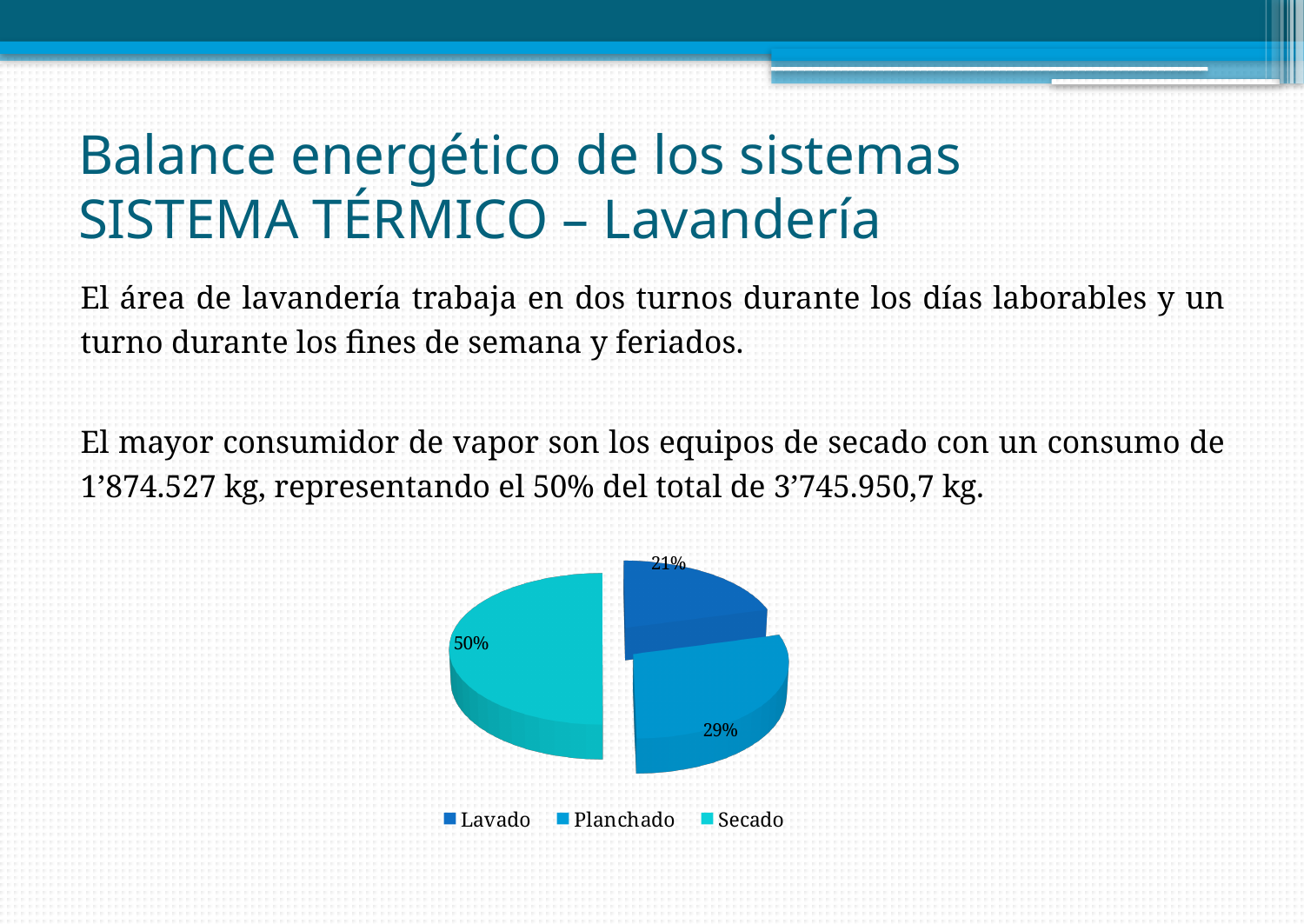
What share of the pie does Planchado represent? 29% What share of the pie does Secado represent? 50% Which category has the largest slice of the pie? Secado How many categories does the pie chart show? 3 How many entries does the legend list? 3 What kind of chart is shown on the slide? pie chart Which slice is larger, Planchado or Lavado? Planchado What is the difference in percentage points between the Planchado and Lavado slices? 8 What share of the pie does Lavado represent? 21% Which category has the smallest slice of the pie? Lavado What is the difference in percentage points between the Secado and Planchado slices? 21 Which category is shown in the lightest (cyan) colour in the legend? Secado